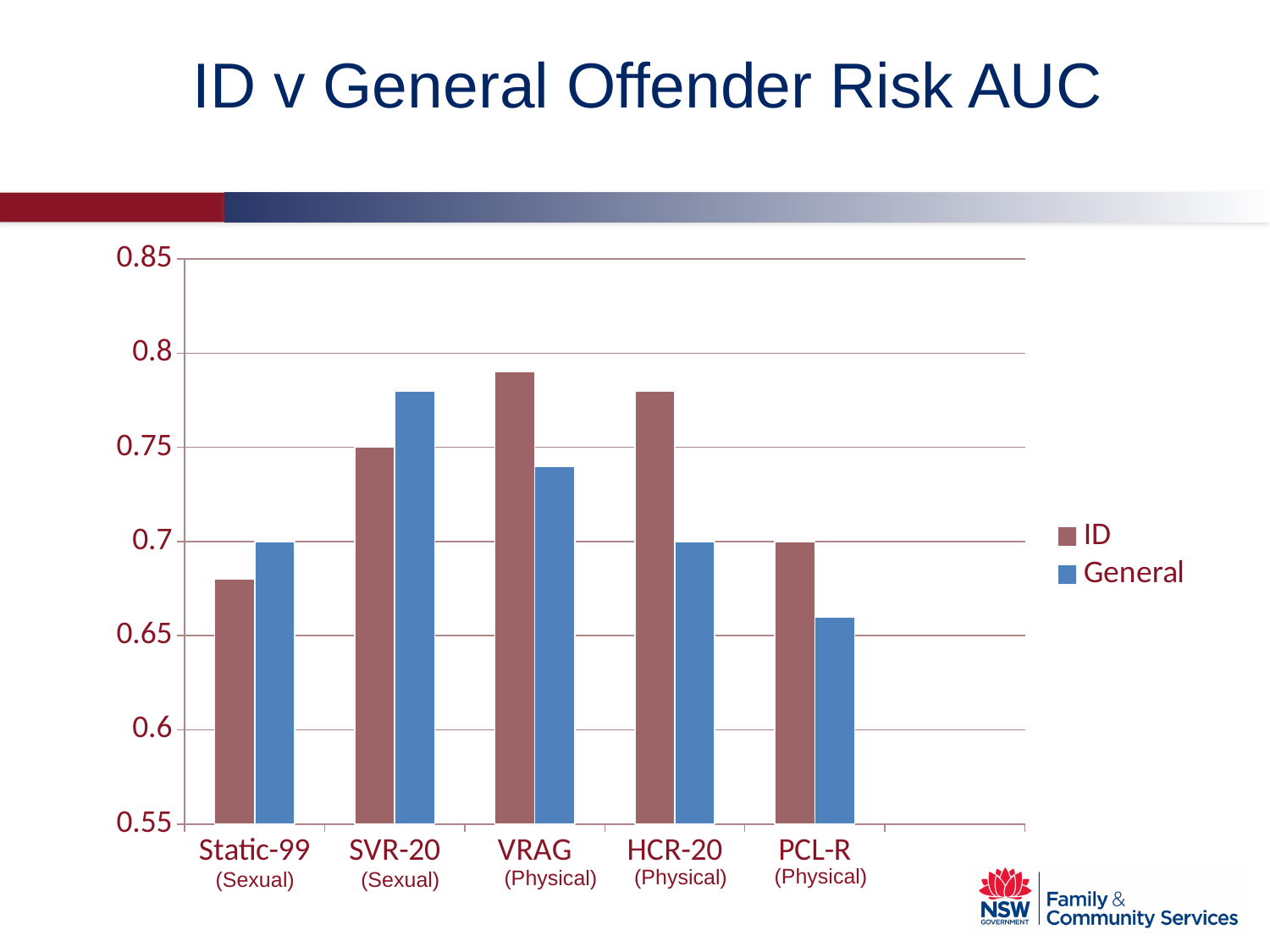
Which instrument has the highest General value? SVR-20 Is the General value for PCL-R greater or less than 0.7? less Which instrument has the lowest ID value? Static-99 Is the General value for SVR-20 greater or less than 0.75? greater How many series does the legend list? 2 What kind of chart is shown on the slide? bar chart What are the two series named in the legend? ID and General Which instrument has the lowest General value? PCL-R For VRAG, which is larger, the ID value or the General value? ID What is the title of the slide's chart? ID v General Offender Risk AUC Is the ID value for Static-99 greater or less than 0.7? less How many risk instruments (categories) are shown on the x axis? 5